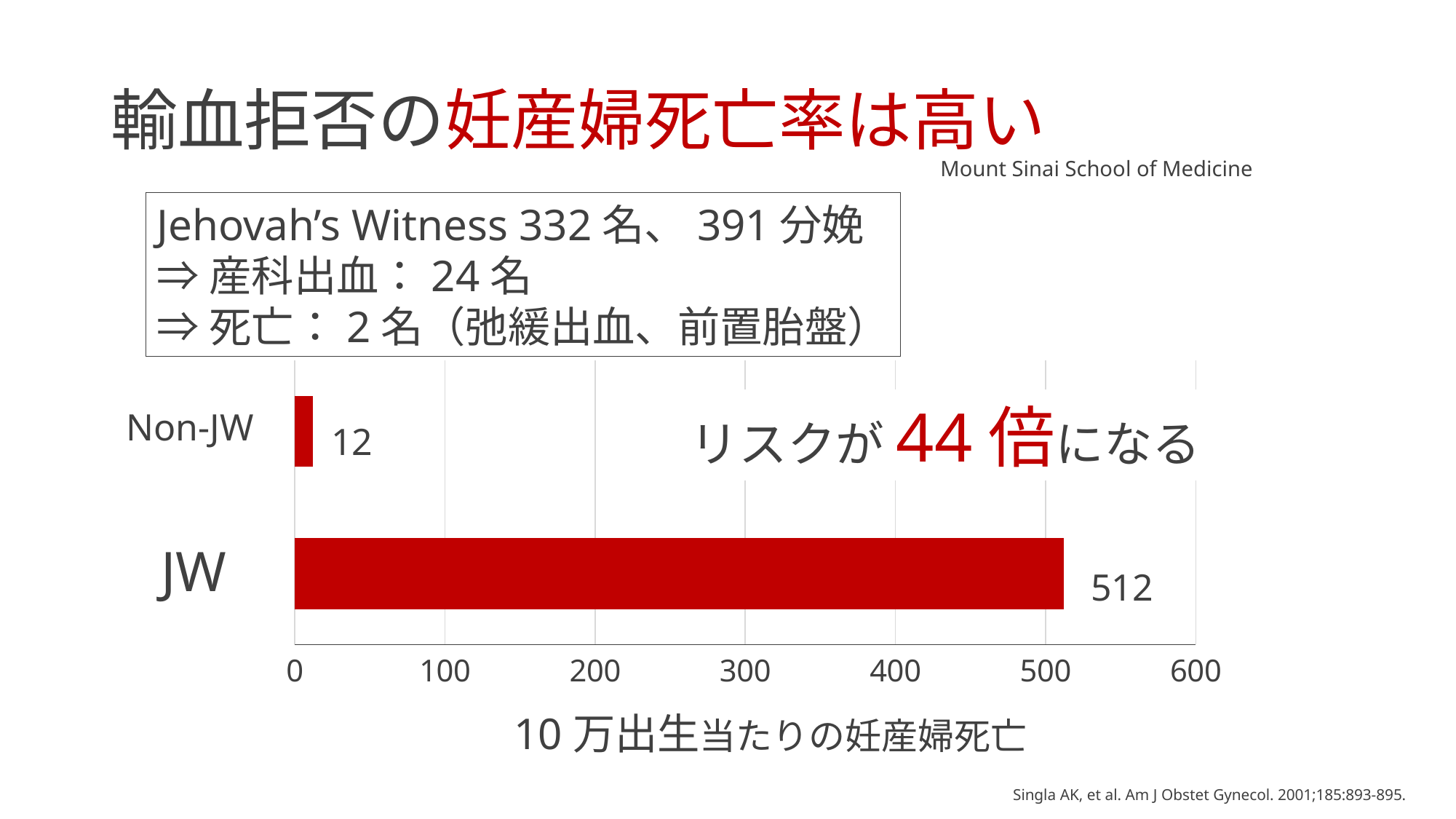
What is the value for JW? 512 What is the value for Non-JW? 12 What is the x-axis label of the chart? 10万出生当たりの妊産婦死亡 What is the difference between the values for JW and Non-JW? 500 Is the value for JW greater or less than 500? greater Which is larger, the value for JW or the value for Non-JW? JW How many categories are shown in the chart? 2 Which category has the lowest value? Non-JW What is the maximum value shown on the x axis? 600 Is the value for Non-JW greater or less than 100? less Which category has the highest value? JW What kind of chart is shown on the slide? bar chart